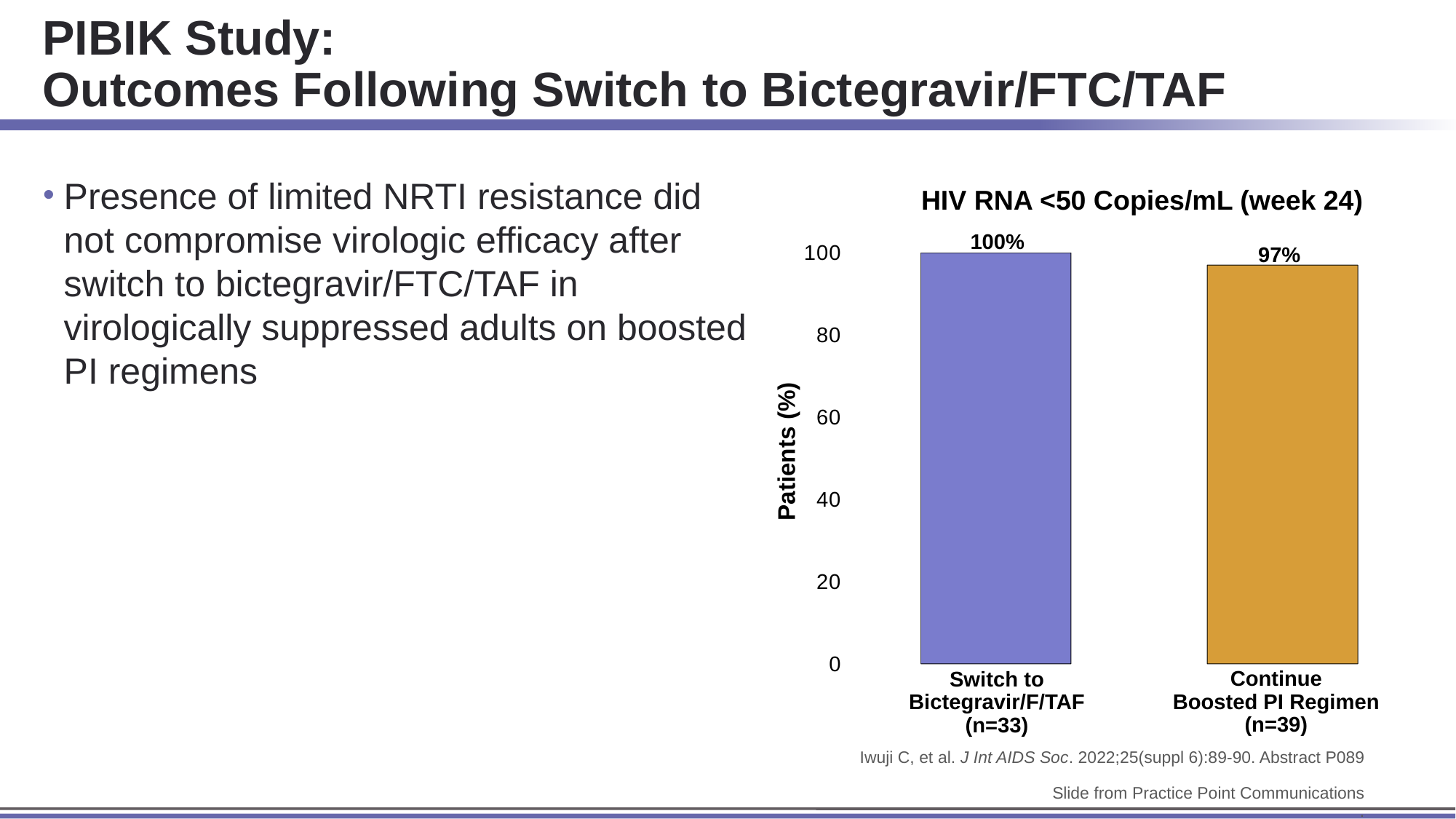
Is the value for the Switch to Bictegravir/F/TAF group larger or smaller than the value for the Continue Boosted PI Regimen group? larger How many patients were in the Continue Boosted PI Regimen group? 39 Is the value for the Continue Boosted PI Regimen group greater or less than 80? greater What kind of chart is shown on the slide? bar chart Which group has the higher percentage of patients with HIV RNA <50 copies/mL? Switch to Bictegravir/F/TAF What is the label of the y-axis of the chart? Patients (%) What percentage of patients in the Switch to Bictegravir/F/TAF group had HIV RNA <50 copies/mL at week 24? 100% Which group has the lower percentage of patients with HIV RNA <50 copies/mL? Continue Boosted PI Regimen What is the difference in percentage points between the Switch to Bictegravir/F/TAF group and the Continue Boosted PI Regimen group? 3 What percentage of patients in the Continue Boosted PI Regimen group had HIV RNA <50 copies/mL at week 24? 97% What is the title of the chart? HIV RNA <50 Copies/mL (week 24) How many groups are shown in the chart? 2